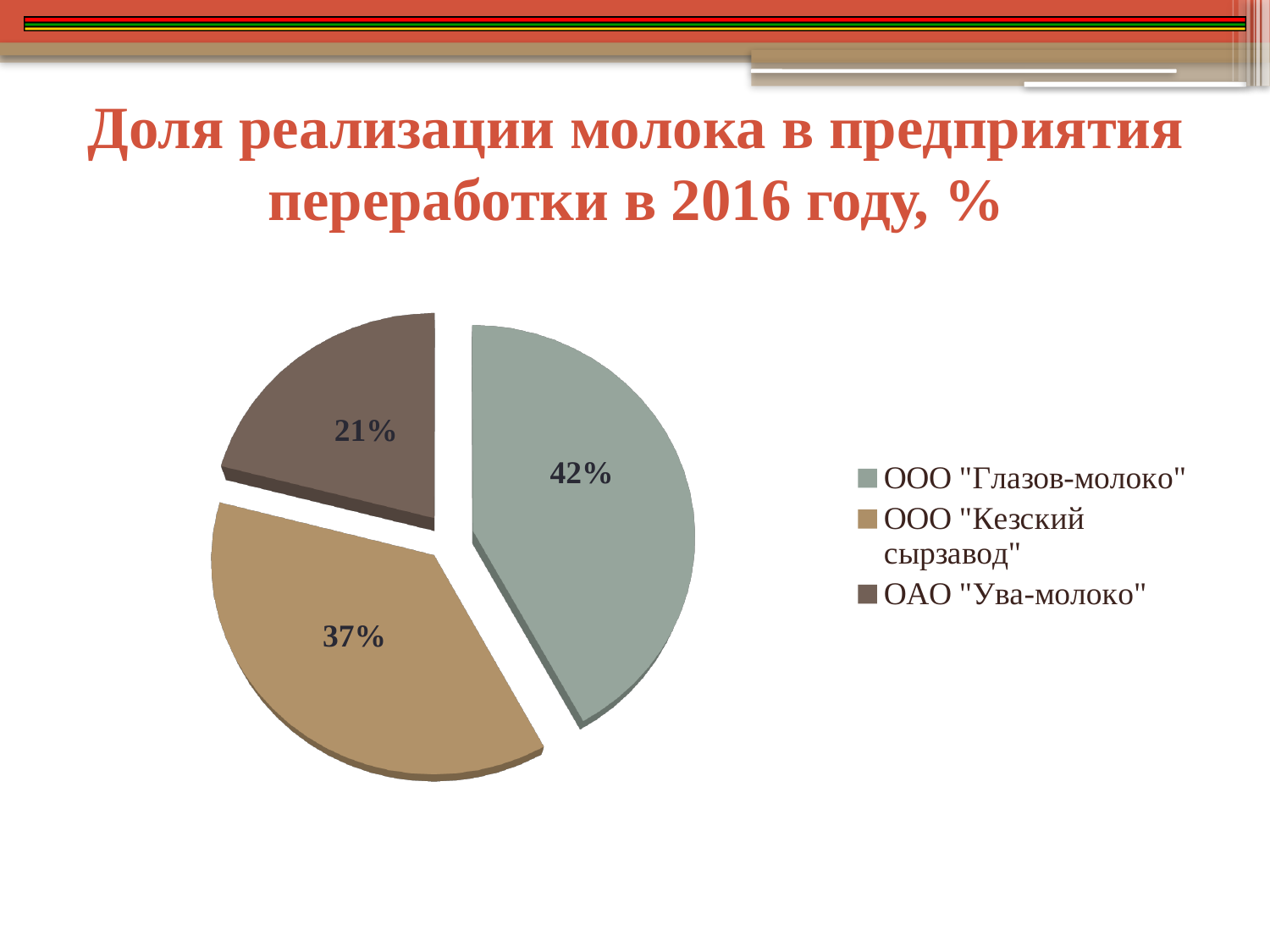
Which enterprise has the smallest share of milk sales? ОАО "Ува-молоко" Which enterprise is represented by the dark brown slice? ОАО "Ува-молоко" What share of milk sales goes to ООО "Глазов-молоко"? 42% Which has a larger share: ООО "Кезский сырзавод" or ОАО "Ува-молоко"? ООО "Кезский сырзавод" What is the difference between the shares of ООО "Глазов-молоко" and ОАО "Ува-молоко"? 21% Which enterprise has the largest share of milk sales? ООО "Глазов-молоко" What share of milk sales goes to ООО "Кезский сырзавод"? 37% How many enterprises are shown in the pie chart? 3 What is the title of the chart? Доля реализации молока в предприятия переработки в 2016 году, % What is the difference between the shares of ООО "Глазов-молоко" and ООО "Кезский сырзавод"? 5% What share of milk sales goes to ОАО "Ува-молоко"? 21% What kind of chart is shown on the slide? Pie chart